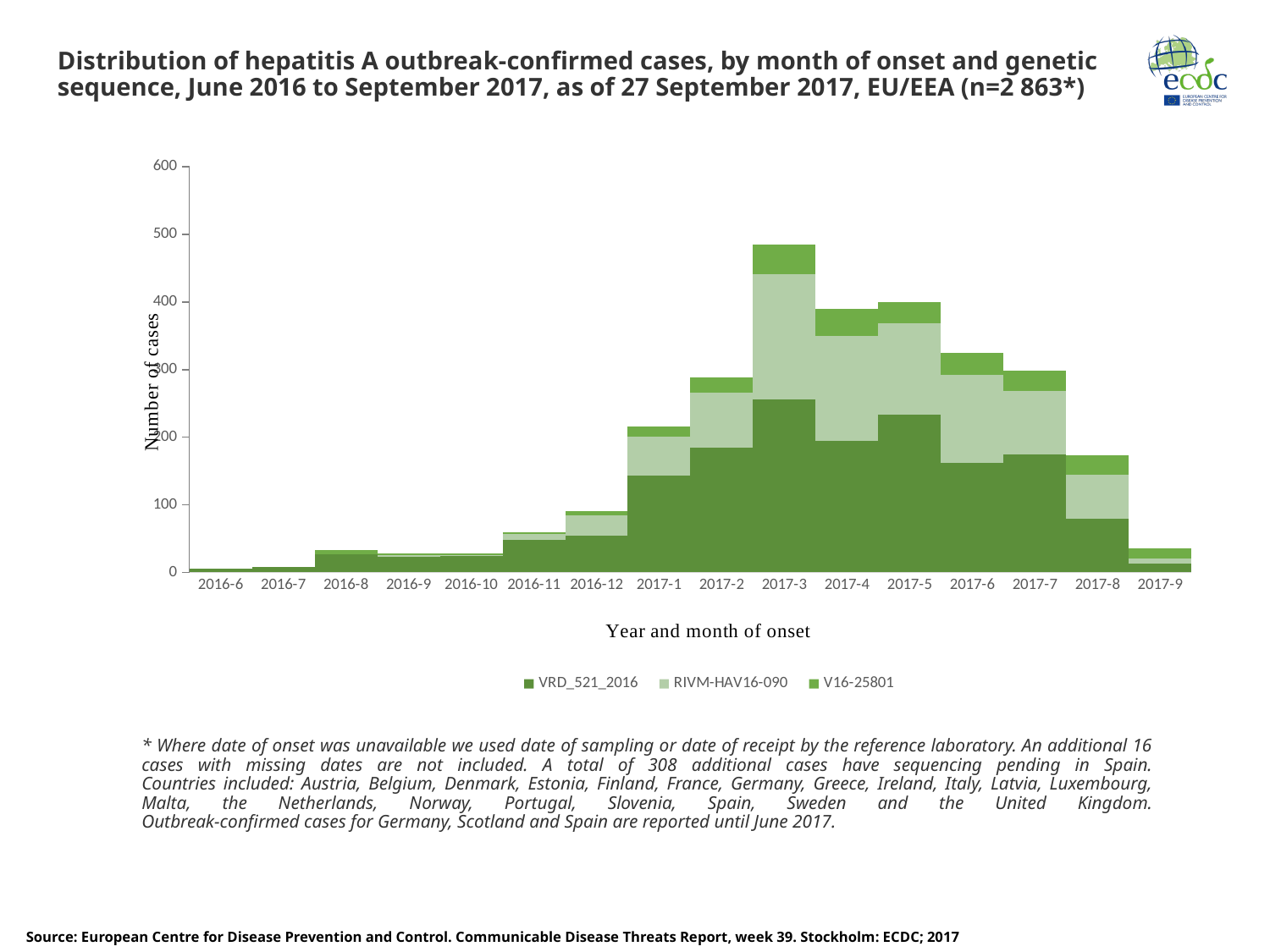
How many series does the legend list? 3 Which month has the highest total number of cases? 2017-3 Do the total number of cases rise or fall from 2017-3 to 2017-9? fall Is the total number of cases for 2017-8 greater or less than 200? less How many months (categories) are shown along the x axis? 16 Is the total number of cases for 2017-3 greater or less than 400? greater Which month has the larger total number of cases, 2017-3 or 2017-5? 2017-3 Is the total number of cases for 2016-12 greater or less than 100? less What is the title of the y axis? Number of cases What kind of chart is shown on the slide? Stacked bar chart Which month has the larger total number of cases, 2017-6 or 2017-8? 2017-6